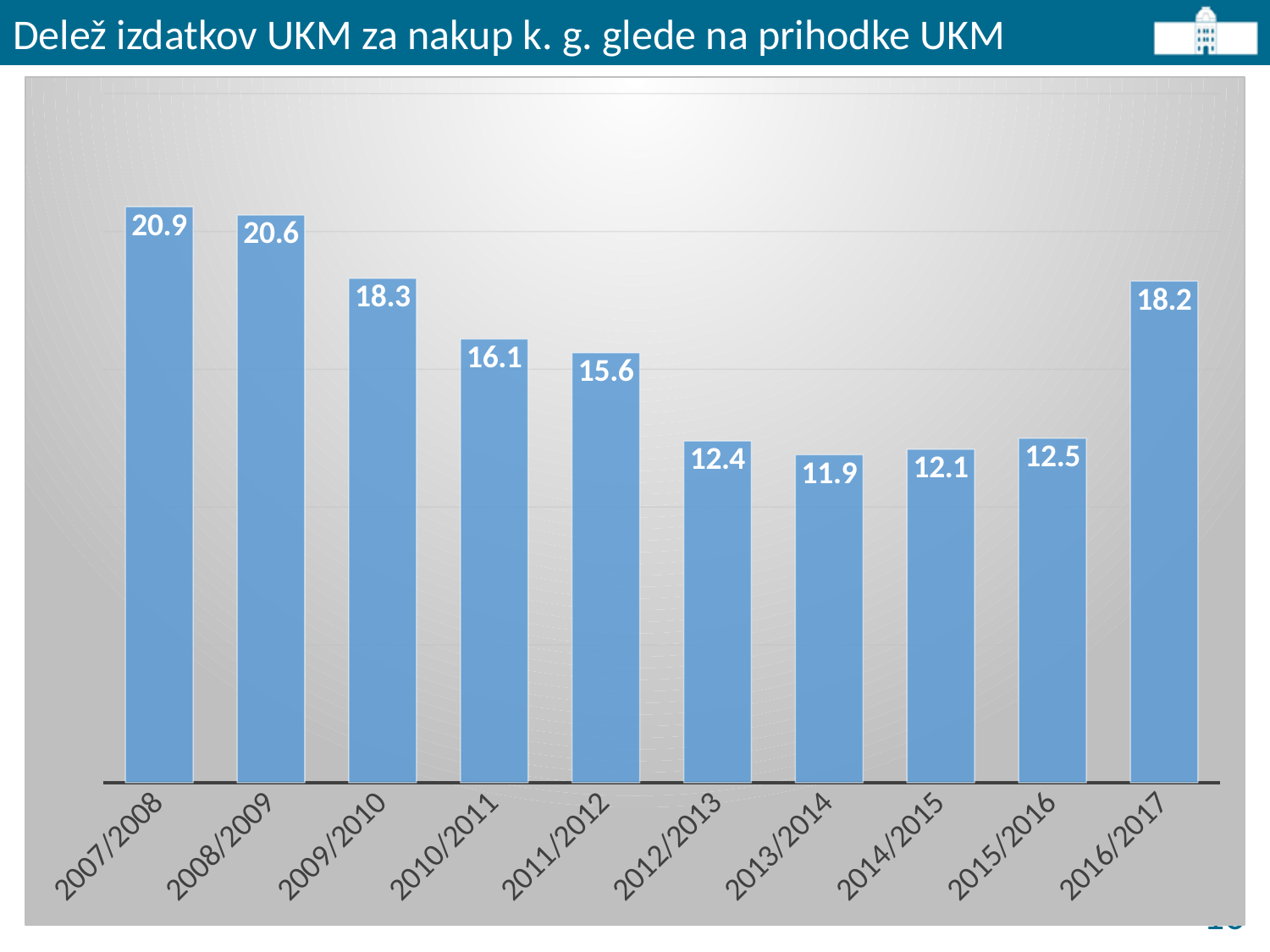
What is the value for 2016/2017? 18.2 Which year has the lowest value? 2013/2014 Which is larger, the value for 2016/2017 or the value for 2009/2010? 2009/2010 What kind of chart is shown on the slide? bar chart How many years are shown on the chart? 10 What is the difference between the values for 2009/2010 and 2010/2011? 2.2 What is the value for 2013/2014? 11.9 What is the difference between the values for 2007/2008 and 2013/2014? 9.0 What is the value for 2007/2008? 20.9 Which year has the highest value? 2007/2008 Which is larger, the value for 2011/2012 or the value for 2015/2016? 2011/2012 Do the values rise or fall from 2007/2008 to 2013/2014? fall